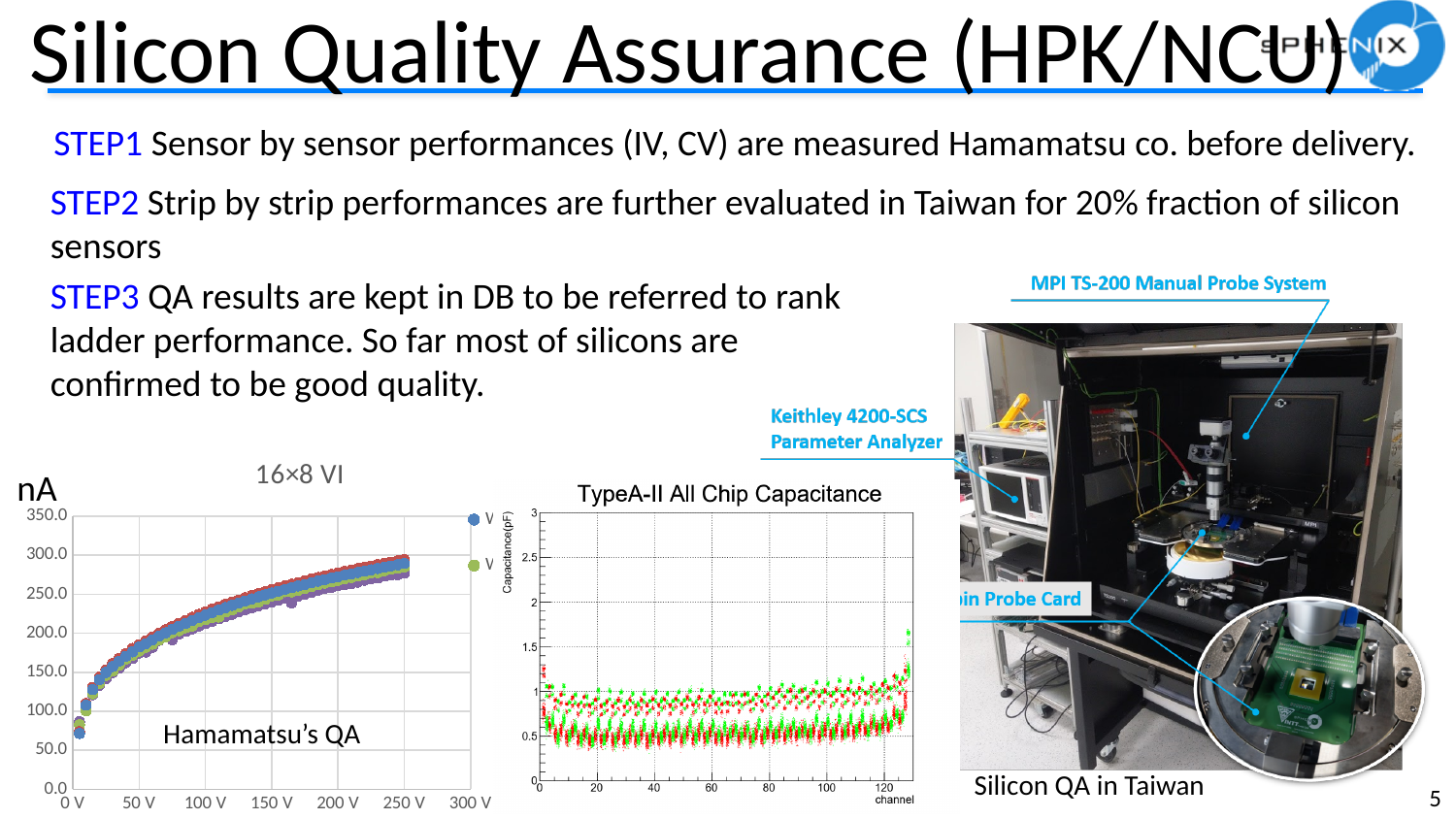
In the TypeA-II All Chip Capacitance chart, are the plotted capacitance values mostly greater or less than 1.5? less In the TypeA-II All Chip Capacitance chart, what is the label of the y axis? Capacitance(pF) In the TypeA-II All Chip Capacitance chart, what is the label of the x axis? channel In the 16×8 VI chart, what is the highest tick value shown on the y axis? 350.0 In the 16×8 VI chart, is the value at 250 V greater or less than 250.0? greater In the 16×8 VI chart, is the value at 200 V greater or less than 250.0? greater In the 16×8 VI chart, what is the highest tick value shown on the x axis? 300 V In the 16×8 VI chart, do the values rise or fall as the voltage increases along the x axis? rise In the 16×8 VI chart, what unit is shown on the y axis? nA What is the title of the chart in the middle of the slide? TypeA-II All Chip Capacitance What is the title of the chart on the left of the slide? 16×8 VI